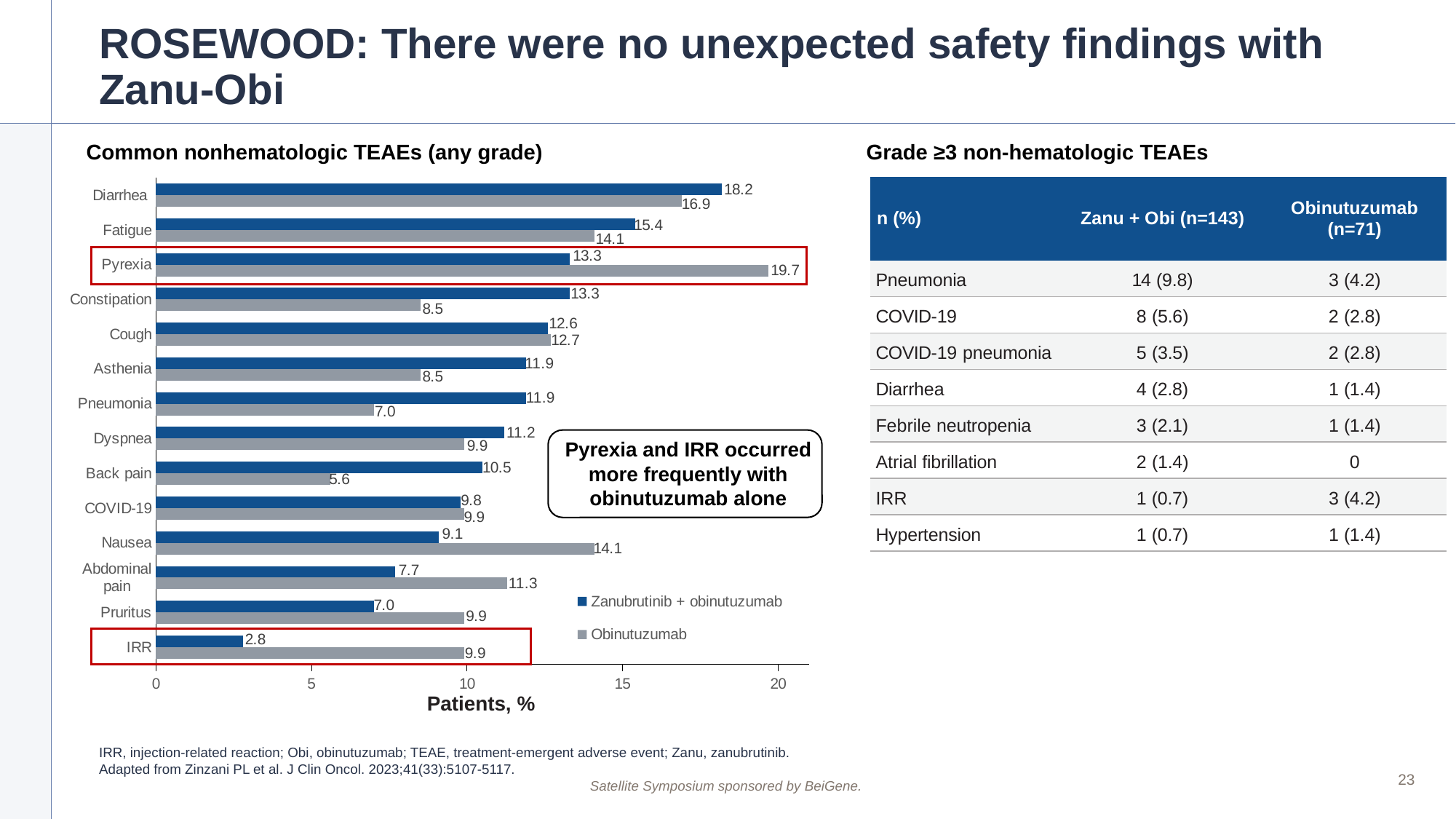
How many series does the legend of the common nonhematologic TEAEs chart list? 2 In the common nonhematologic TEAEs chart, which category has the highest value in the Obinutuzumab series? Pyrexia In the common nonhematologic TEAEs chart, what is the difference between the Obinutuzumab and Zanubrutinib + obinutuzumab values for IRR? 7.1 In the common nonhematologic TEAEs chart, what is the value for Diarrhea in the Zanubrutinib + obinutuzumab series? 18.2 In the common nonhematologic TEAEs chart, which category has the lowest value in the Obinutuzumab series? Back pain In the common nonhematologic TEAEs chart, what is the value for IRR in the Zanubrutinib + obinutuzumab series? 2.8 What type of chart is used to show the common nonhematologic TEAEs? Bar chart What is the x-axis label of the common nonhematologic TEAEs chart? Patients, % In the common nonhematologic TEAEs chart, what is the value for Pyrexia in the Obinutuzumab series? 19.7 How many adverse event categories are shown in the common nonhematologic TEAEs chart? 14 In the common nonhematologic TEAEs chart, which series has the larger value for Nausea? Obinutuzumab In the common nonhematologic TEAEs chart, which category has the lowest value in the Zanubrutinib + obinutuzumab series? IRR